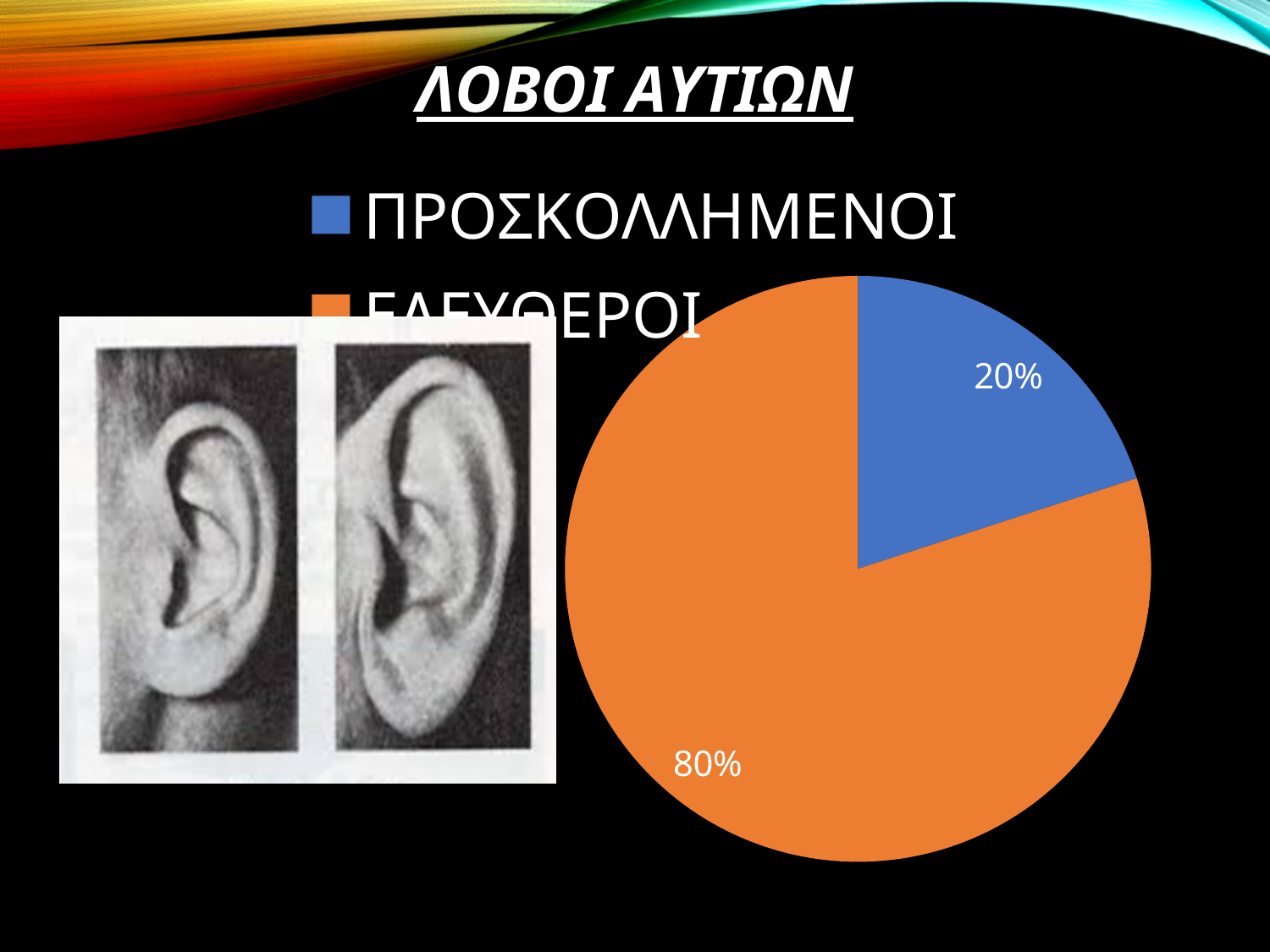
What share of the pie does ΕΛΕΥΘΕΡΟΙ represent? 80% What is the difference in percentage points between the ΕΛΕΥΘΕΡΟΙ and ΠΡΟΣΚΟΛΛΗΜΕΝΟΙ slices? 60% Which category has the smallest slice of the pie? ΠΡΟΣΚΟΛΛΗΜΕΝΟΙ How many entries does the legend list? 2 How many slices does the pie chart have? 2 What kind of chart is shown on the slide? pie chart Which category has the largest slice of the pie? ΕΛΕΥΘΕΡΟΙ Which is larger, the ΠΡΟΣΚΟΛΛΗΜΕΝΟΙ slice or the ΕΛΕΥΘΕΡΟΙ slice? ΕΛΕΥΘΕΡΟΙ What is the title of the slide containing the pie chart? ΛΟΒΟΙ ΑΥΤΙΩΝ What colour is the ΠΡΟΣΚΟΛΛΗΜΕΝΟΙ slice? blue What share of the pie does ΠΡΟΣΚΟΛΛΗΜΕΝΟΙ represent? 20%